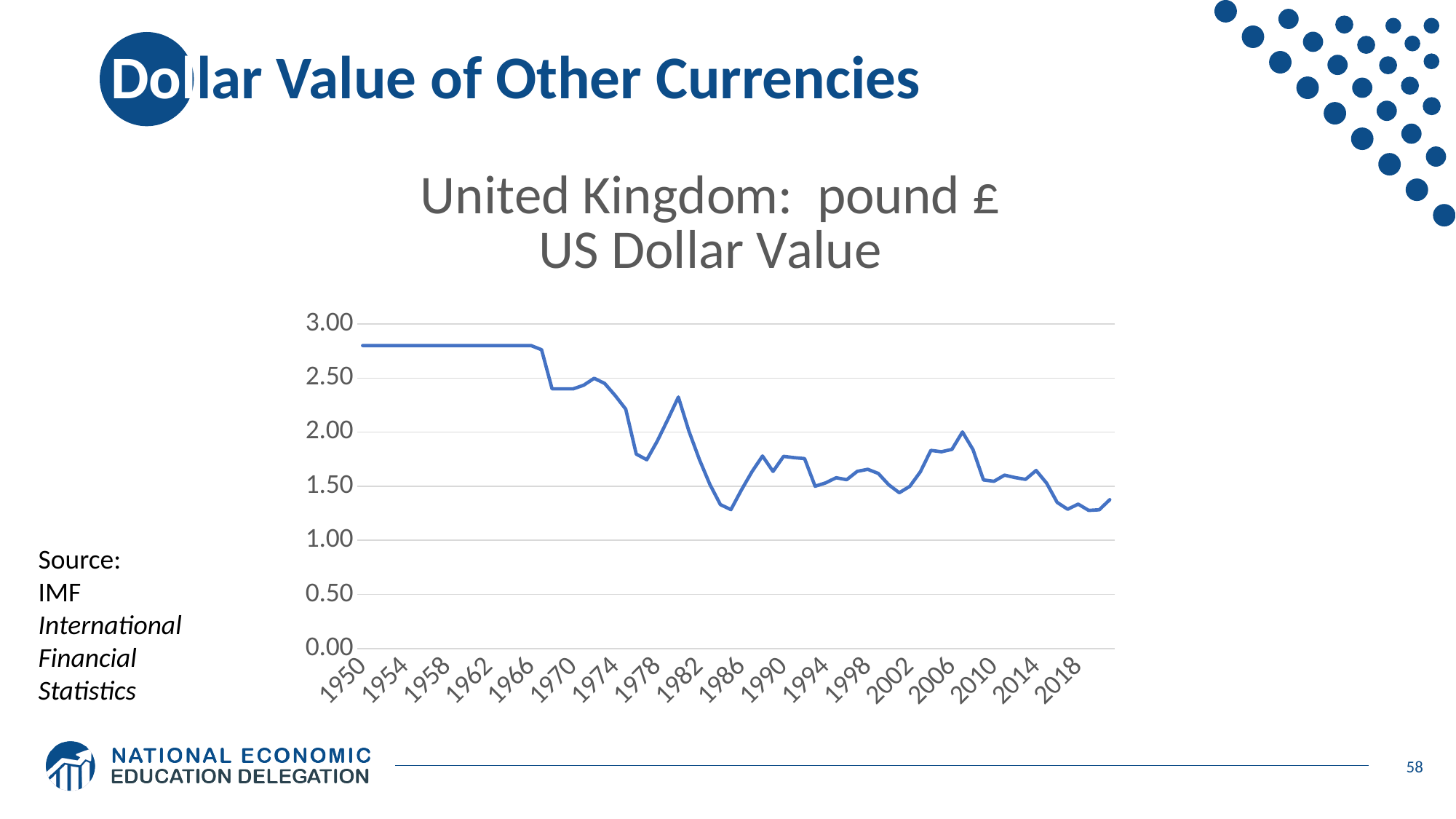
Which year has the larger value, 1950 or 2018? 1950 Is the value for 2018 greater or less than 1.50? less Is the value for 1950 greater or less than 2.50? greater What kind of chart is shown on the slide? line chart Which year has the larger value, 1970 or 1986? 1970 What is the title of the chart? United Kingdom: pound £ US Dollar Value Is the value for 1990 greater or less than 1.50? greater Overall, do the values rise or fall from 1950 to 2018? fall What is the highest value shown on the vertical axis? 3.00